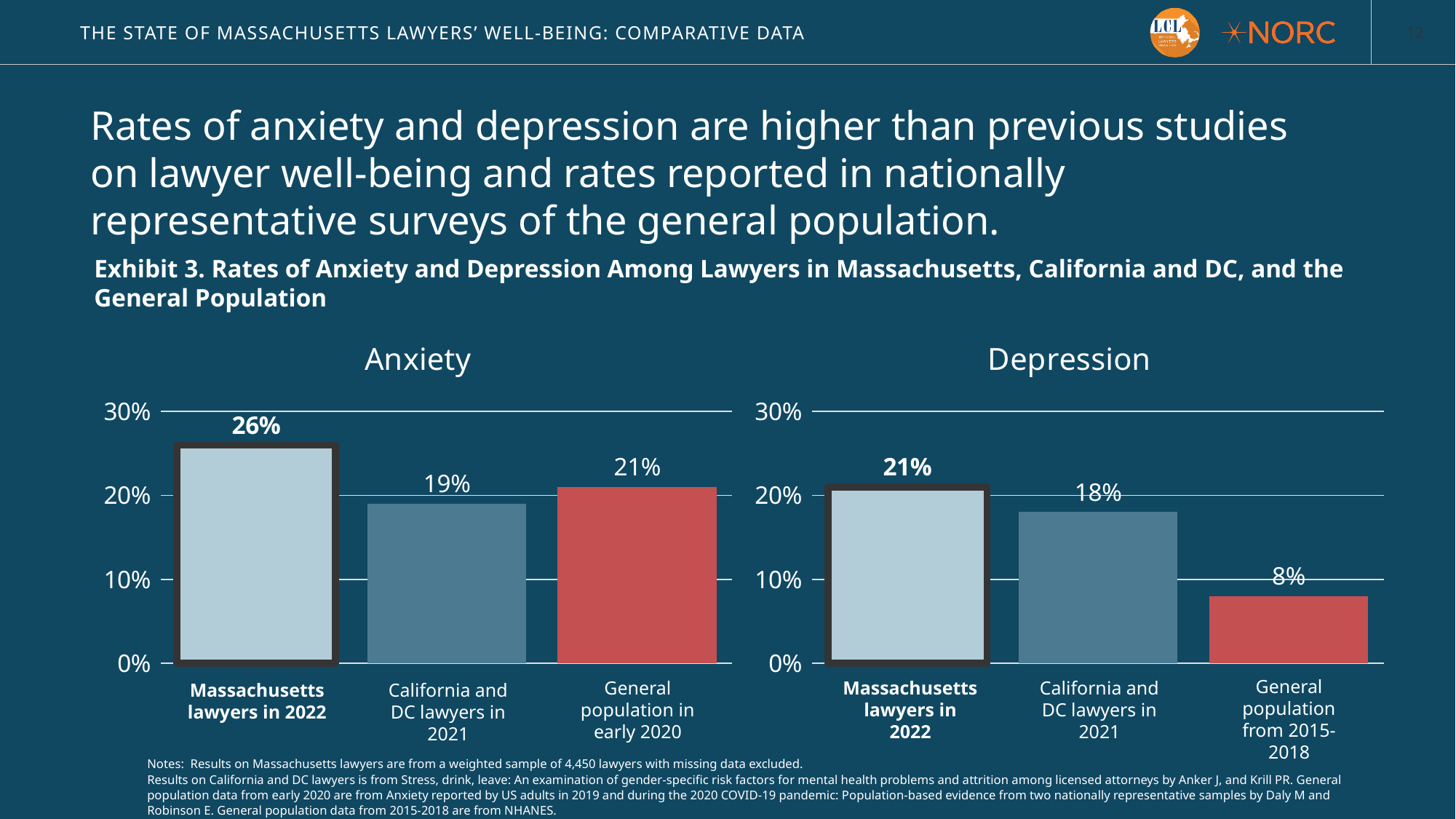
How many categories are shown in the Depression chart? 3 In the Depression chart, what is the value for Massachusetts lawyers in 2022? 21% What kind of chart is the Anxiety chart? Bar chart In the Anxiety chart, what is the difference between Massachusetts lawyers in 2022 and the general population in early 2020? 5% In the Depression chart, what is the value for the general population from 2015-2018? 8% In the Anxiety chart, which is larger: the value for California and DC lawyers in 2021 or the general population in early 2020? General population in early 2020 In the Anxiety chart, what is the value for California and DC lawyers in 2021? 19% In the Depression chart, what is the difference between Massachusetts lawyers in 2022 and California and DC lawyers in 2021? 3% In the Depression chart, which category has the lowest value? General population from 2015-2018 In the Anxiety chart, which category has the highest value? Massachusetts lawyers in 2022 In the Anxiety chart, what is the value for Massachusetts lawyers in 2022? 26% In the Depression chart, do the values rise or fall from left to right? Fall